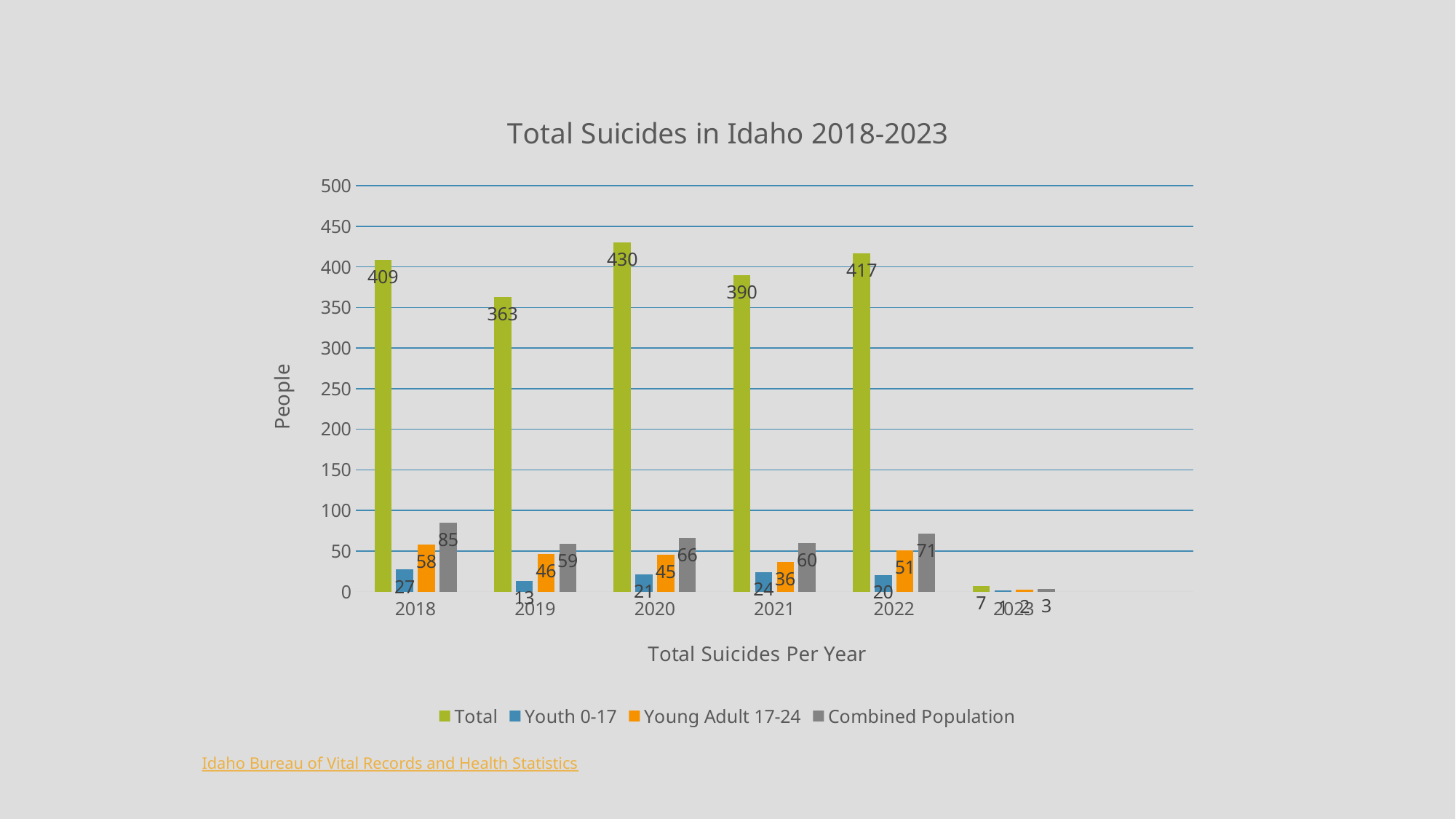
What is the Total value for 2020? 430 What is the difference between the Total values for 2020 and 2019? 67 What kind of chart is shown on the slide? Bar chart What is the title of the y axis? People What is the Combined Population value for 2019? 59 Which year has the lowest Combined Population value among 2018 to 2022? 2019 Which year has the highest Total value? 2020 What is the Youth 0-17 value for 2018? 27 How many years are shown on the x axis? 6 Which is larger, the Combined Population value for 2018 or for 2022? 2018 How many series does the legend list? 4 What is the Young Adult 17-24 value for 2022? 51